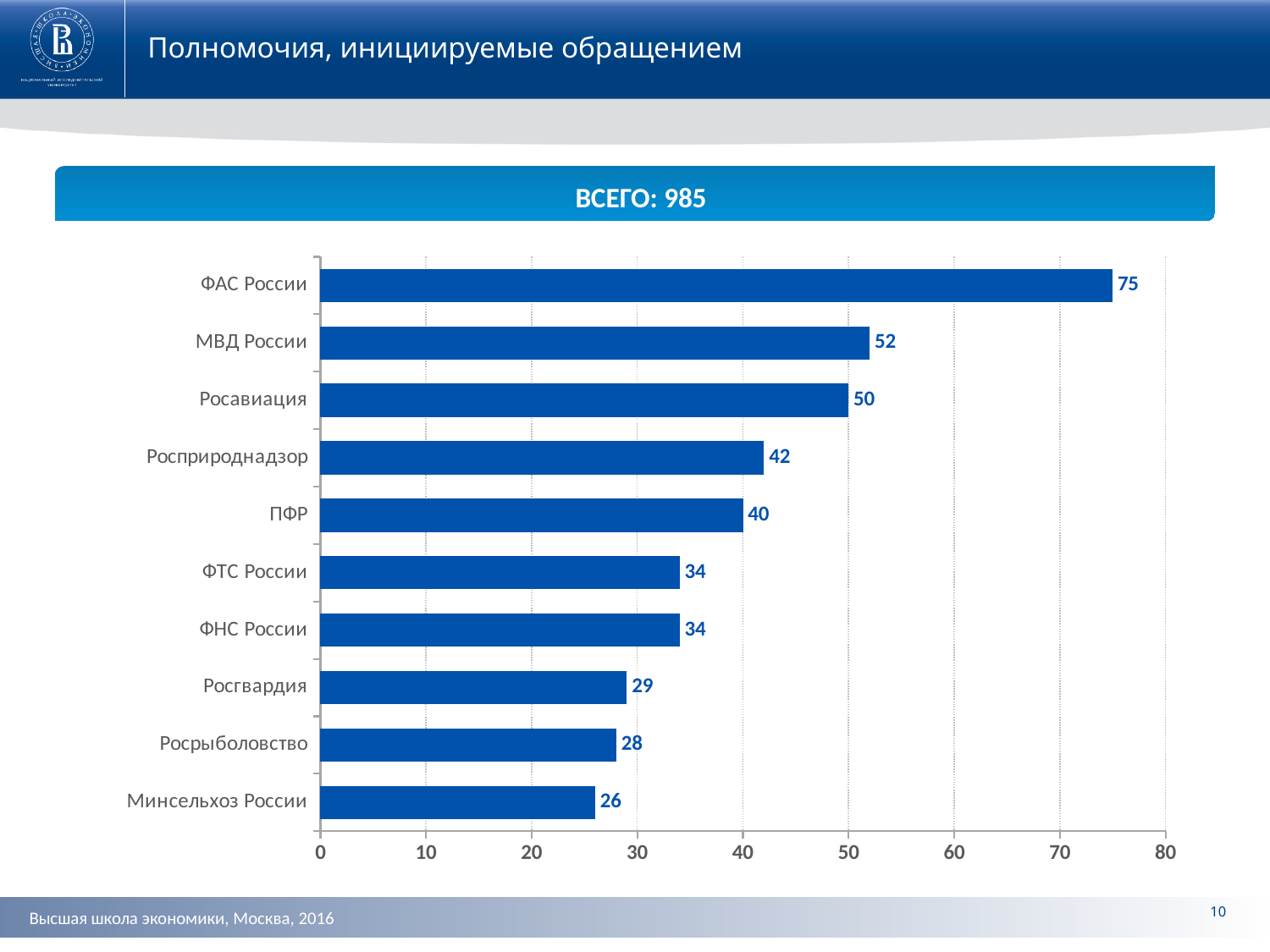
Is the value for МВД России greater or less than 50? greater What is the difference between the values for ПФР and Росгвардия? 11 Which category has the highest value? ФАС России What total is stated in the banner above the chart? ВСЕГО: 985 How many categories are shown in the chart? 10 What is the difference between the values for ФАС России and МВД России? 23 Which category has the lowest value? Минсельхоз России What is the value for ФАС России? 75 What is the value for Росприроднадзор? 42 What kind of chart is shown on the slide? bar chart Which is larger, the value for Росавиация or the value for ФТС России? Росавиация What is the value for Росрыболовство? 28